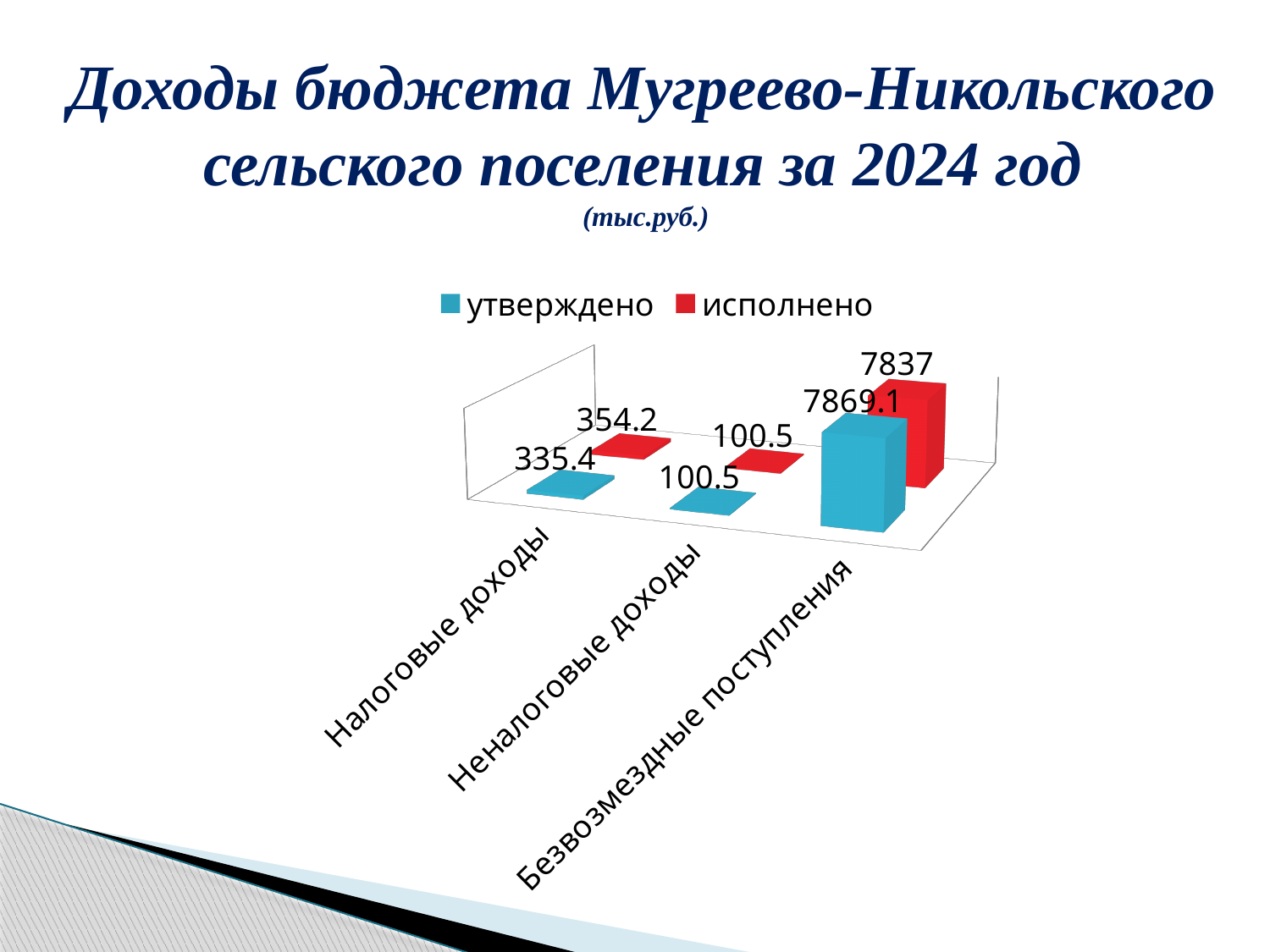
What is the difference between исполнено and утверждено for Налоговые доходы? 18.8 How many series does the legend list? 2 What is the value of утверждено for Безвозмездные поступления? 7869.1 What kind of chart is shown on the slide? Bar chart What is the value of исполнено for Безвозмездные поступления? 7837 What is the value of утверждено for Неналоговые доходы? 100.5 Which category has the highest исполнено value? Безвозмездные поступления How many categories are shown on the x axis? 3 What is the value of утверждено for Налоговые доходы? 335.4 What is the difference between утверждено and исполнено for Безвозмездные поступления? 32.1 Which category has the lowest утверждено value? Неналоговые доходы What is the value of исполнено for Налоговые доходы? 354.2